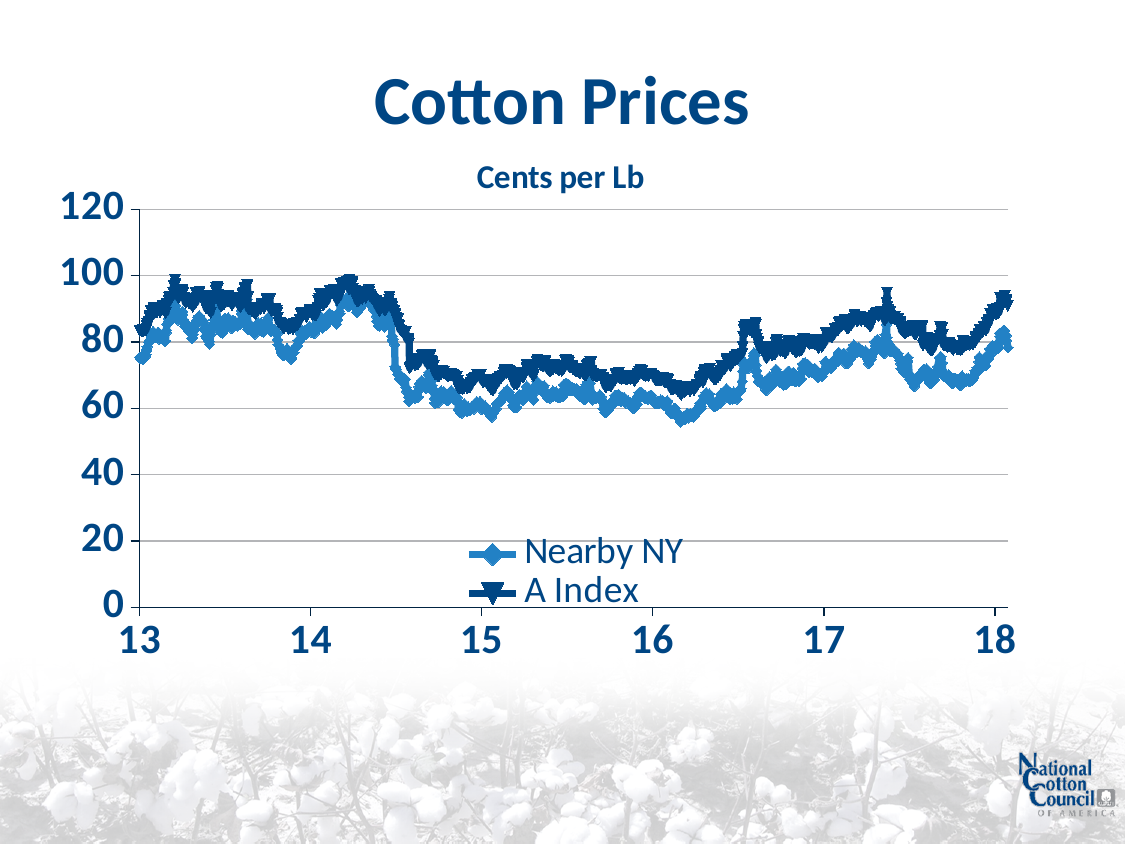
Is the Nearby NY value at 15 greater or less than 80? less What unit is given in the chart's subtitle? Cents per Lb At 15, which series has the higher value, Nearby NY or A Index? A Index Is the Nearby NY value at 16 greater or less than 80? less Which series is plotted above the other across the whole chart? A Index Do the prices rise or fall between 14 and 15 on the x axis? fall How many series does the legend list? 2 What is the title of the chart? Cotton Prices Do the prices rise or fall between 16 and 17 on the x axis? rise Is the A Index value at 14 greater or less than 80? greater What kind of chart is shown on the slide? line chart